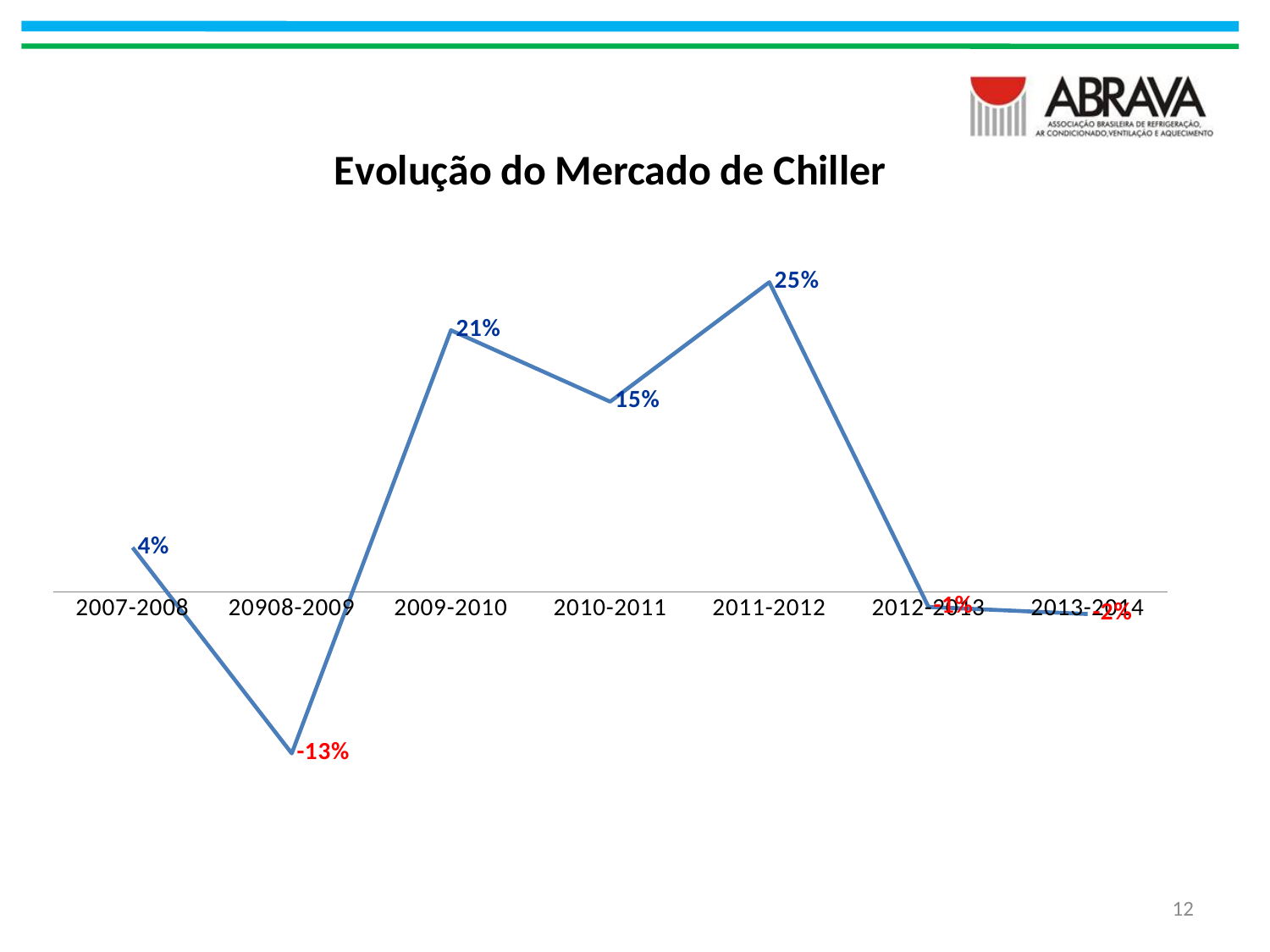
Which is larger, the value for 2009-2010 or the value for 2010-2011? 2009-2010 What kind of chart is shown on the slide? Line chart What is the value for 20908-2009? -13% What is the value for 2010-2011? 15% What is the value for 2011-2012? 25% What is the value for 2007-2008? 4% What is the title of the chart? Evolução do Mercado de Chiller What is the value for 2009-2010? 21% Which period has the highest value? 2011-2012 How many periods are plotted on the x axis? 7 Which period has the lowest value? 20908-2009 What is the difference between the values for 2011-2012 and 2010-2011? 10%